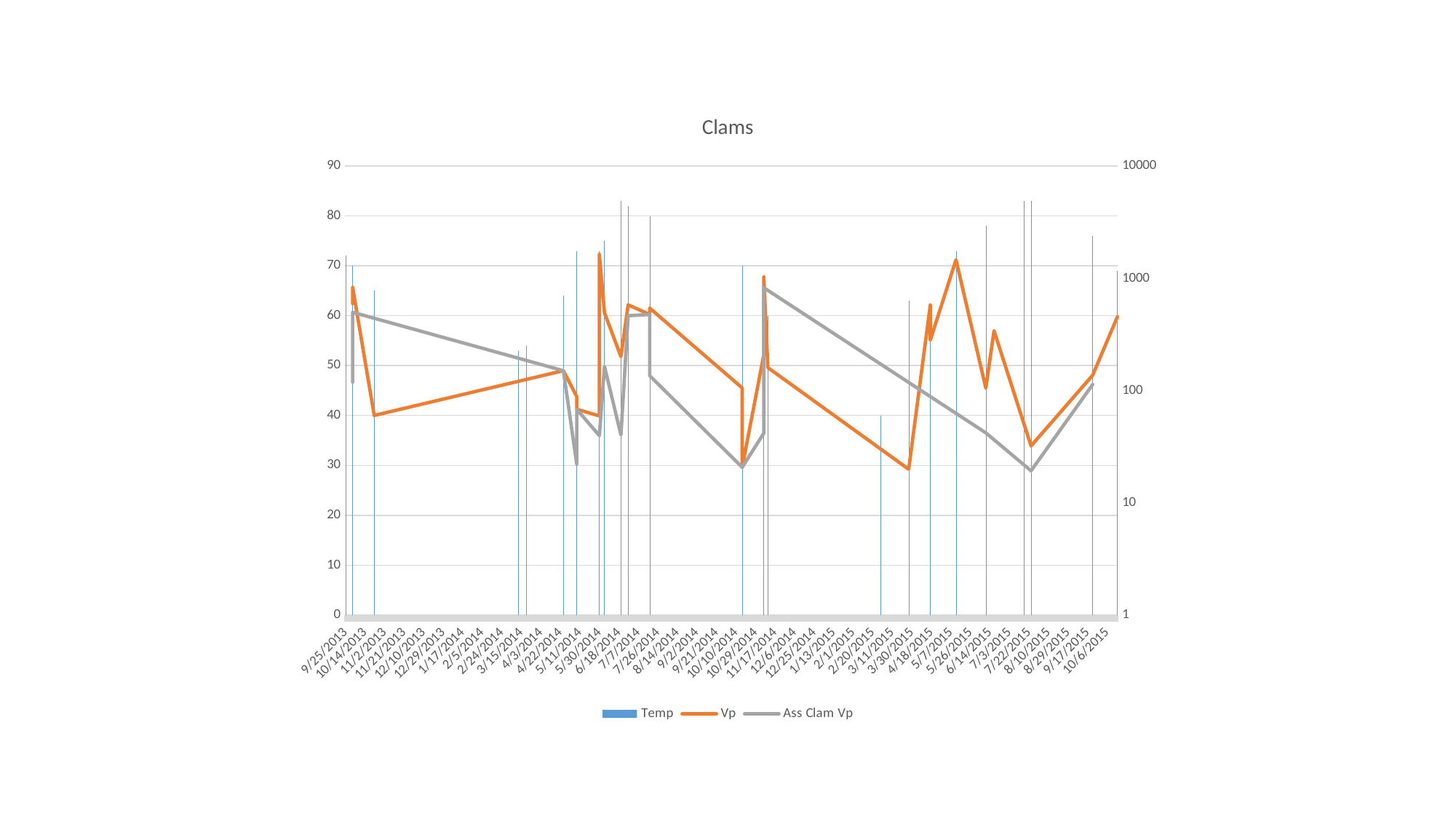
How many series does the legend list? 3 What is the title of the chart? Clams What kind of chart is this? Combination bar and line chart Which series is drawn as bars rather than a line? Temp Does the Vp line rise or fall between 8/10/2015 and 10/6/2015? Rise Does the Ass Clam Vp line rise or fall between 11/17/2014 and 8/10/2015? Fall Does the Vp line rise or fall between 10/14/2013 and 11/2/2013? Fall